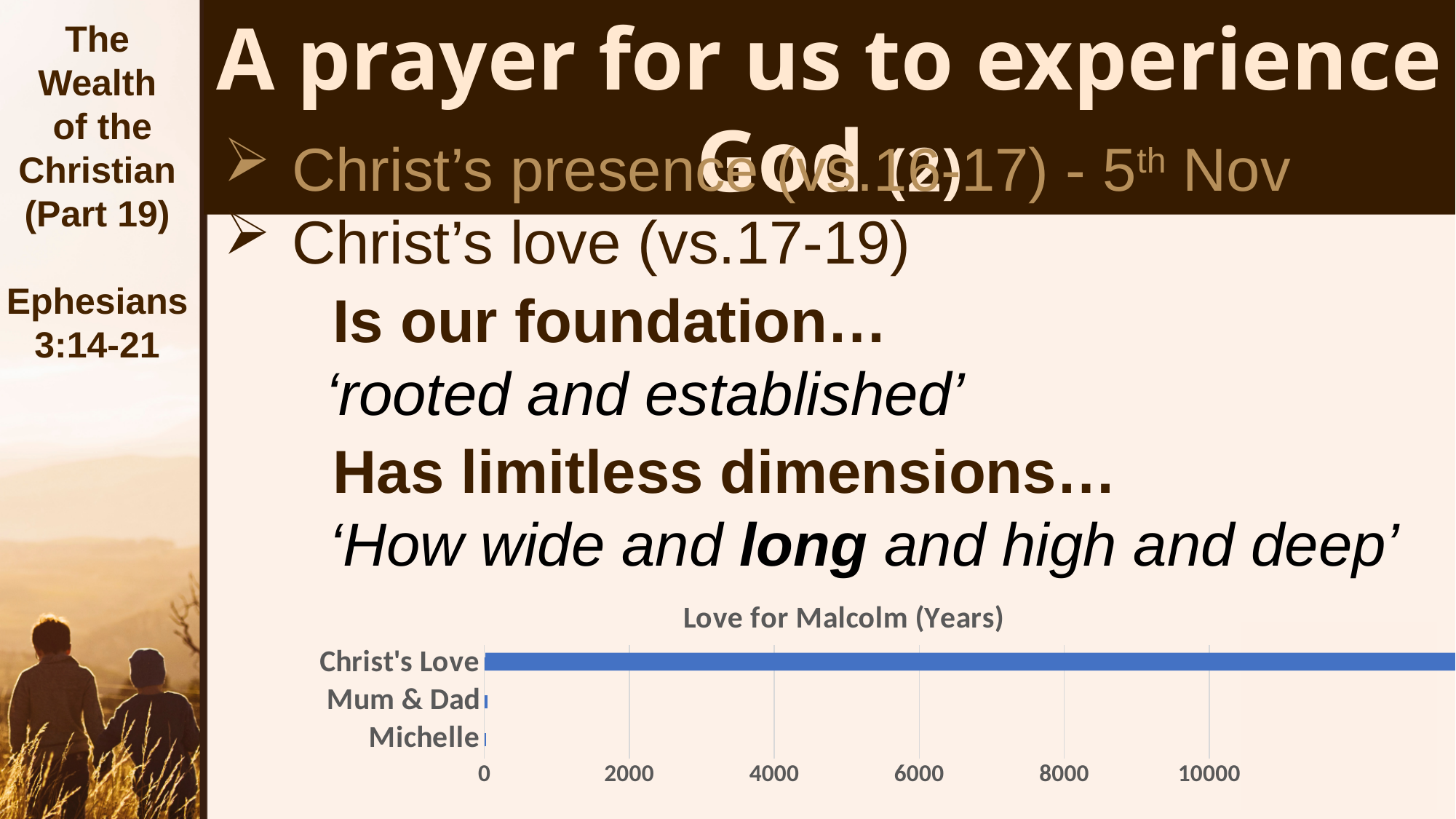
Is the value for Mum & Dad greater or less than 2000? less What is the highest tick label shown on the horizontal axis of the chart? 10000 Which is larger, the value for Christ's Love or the value for Mum & Dad? Christ's Love Which category has the highest value in the chart? Christ's Love What kind of chart is shown on the slide? bar chart How many categories are plotted in the chart? 3 What is the title of the chart? Love for Malcolm (Years) Which is larger, the value for Christ's Love or the value for Michelle? Christ's Love Is the value for Michelle greater or less than 2000? less